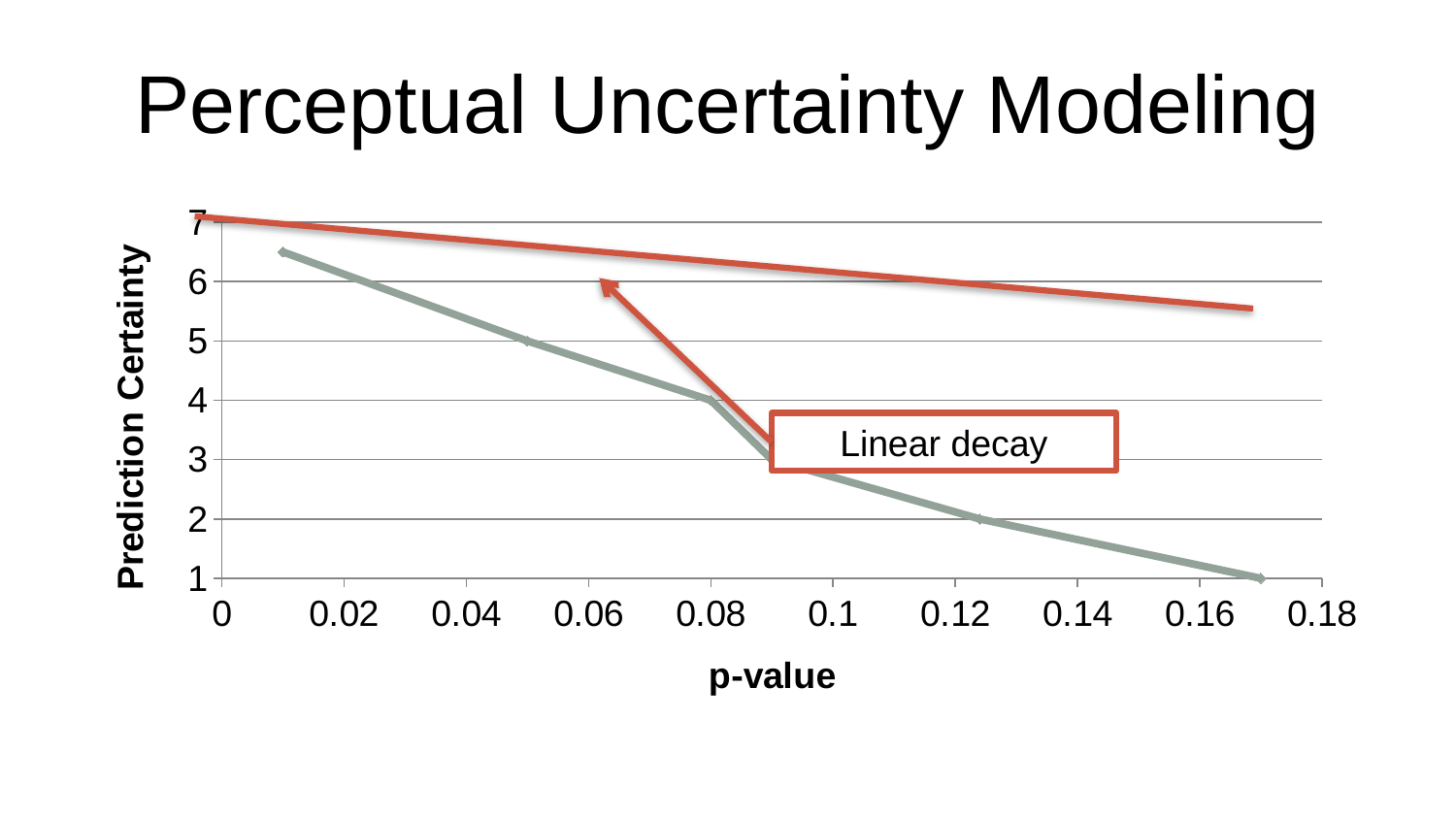
Does the gray line rise or fall as the p-value increases? fall Is the value of the gray line at p-value 0.17 greater or less than 2? less What is the highest value shown on the y axis? 7 What is the label of the y axis? Prediction Certainty What kind of chart is shown on the slide? line chart At p-value 0.12, which line has the higher Prediction Certainty, the gray line or the red 'Linear decay' line? the red 'Linear decay' line Is the value of the red 'Linear decay' line at p-value 0.16 greater or less than 5? greater Does the red line labeled 'Linear decay' rise or fall as the p-value increases? fall Is the value of the gray line at p-value 0.05 greater or less than 6? less What is the label of the x axis? p-value